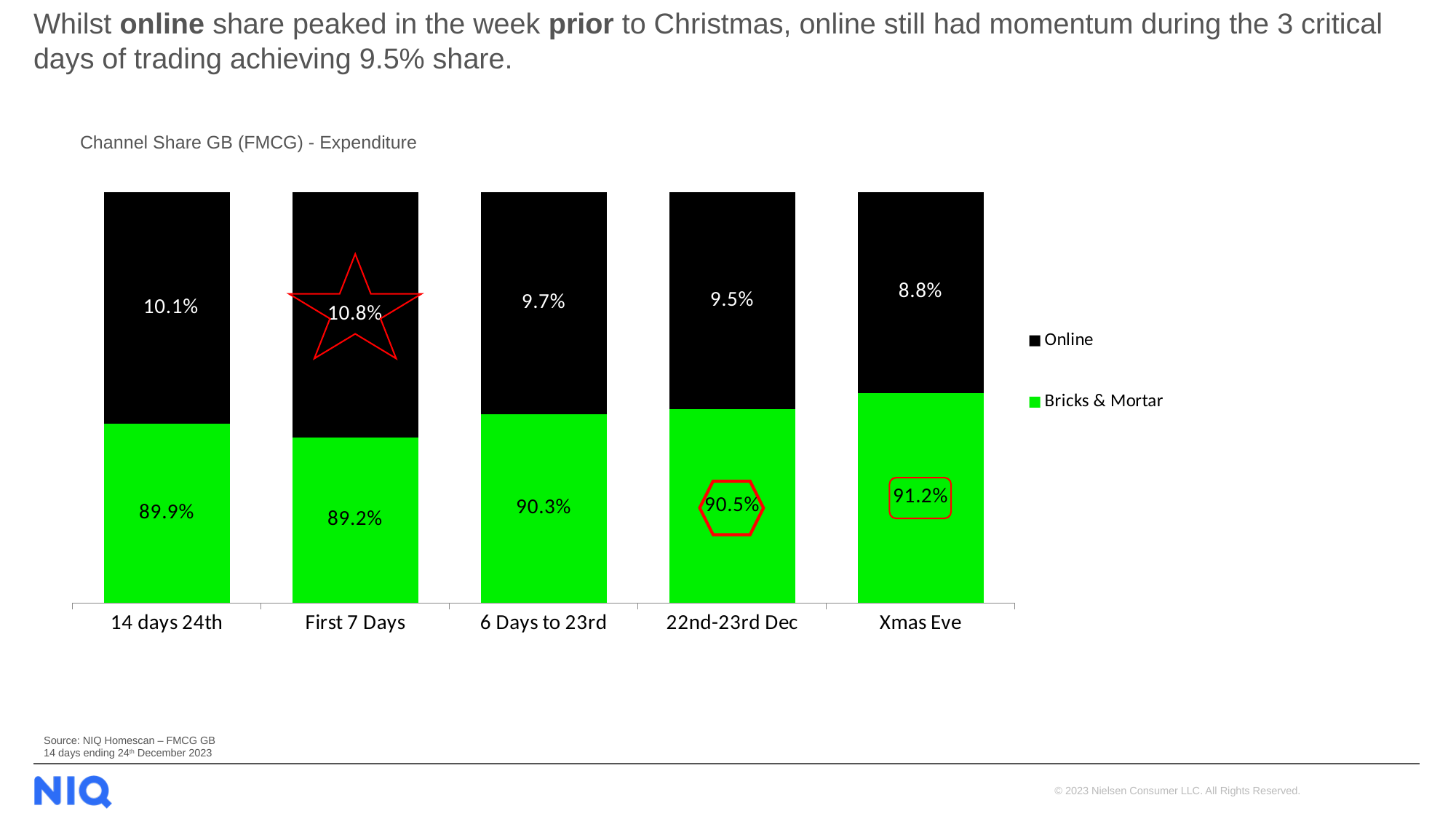
Which period has the highest Online share? First 7 Days What is the Bricks & Mortar share for 14 days 24th? 89.9% Which is larger, the Bricks & Mortar share for 6 Days to 23rd or for 22nd-23rd Dec? 22nd-23rd Dec What is the Online share for 22nd-23rd Dec? 9.5% Does the Online share rise or fall from 6 Days to 23rd through Xmas Eve? Fall What is the difference between the Online share for First 7 Days and Xmas Eve? 2.0% How many periods are shown on the x axis? 5 What is the Bricks & Mortar share on Xmas Eve? 91.2% What kind of chart is shown? Stacked bar chart How many series does the legend list? 2 What is the Online share for the First 7 Days? 10.8% Which period has the lowest Online share? Xmas Eve